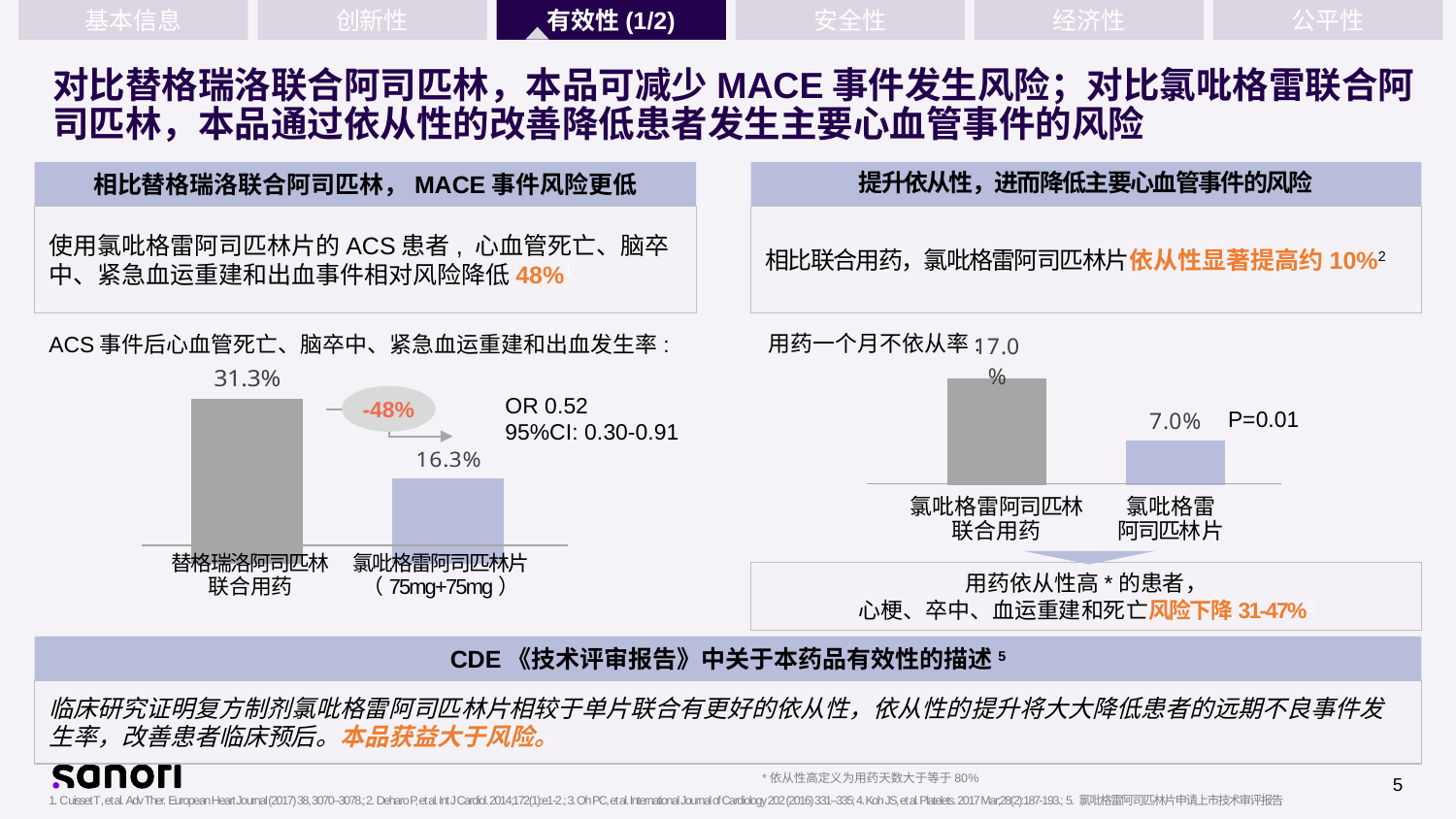
In the right chart (用药一个月不依从率), what is the difference between the two bars? 10.0 percentage points What type of chart is the right chart (用药一个月不依从率)? Bar chart In the left chart (ACS 事件后心血管死亡、脑卒中、紧急血运重建和出血发生率), what is the value for 替格瑞洛阿司匹林联合用药? 31.3% In the left chart (ACS 事件后心血管死亡、脑卒中、紧急血运重建和出血发生率), what relative change is shown in the callout between the two bars? -48% In the left chart (ACS 事件后心血管死亡、脑卒中、紧急血运重建和出血发生率), what is the difference between the two bars? 15.0 percentage points In the right chart (用药一个月不依从率), which category has the lower value? 氯吡格雷阿司匹林片 In the right chart (用药一个月不依从率), what p-value is shown next to the bars? P=0.01 In the left chart (ACS 事件后心血管死亡、脑卒中、紧急血运重建和出血发生率), which category has the higher value? 替格瑞洛阿司匹林联合用药 In the left chart (ACS 事件后心血管死亡、脑卒中、紧急血运重建和出血发生率), how many bars are plotted? 2 In the right chart (用药一个月不依从率), what is the value for 氯吡格雷阿司匹林联合用药? 17.0% In the left chart (ACS 事件后心血管死亡、脑卒中、紧急血运重建和出血发生率), what is the value for 氯吡格雷阿司匹林片（75mg+75mg）? 16.3% In the right chart (用药一个月不依从率), what is the value for 氯吡格雷阿司匹林片? 7.0%